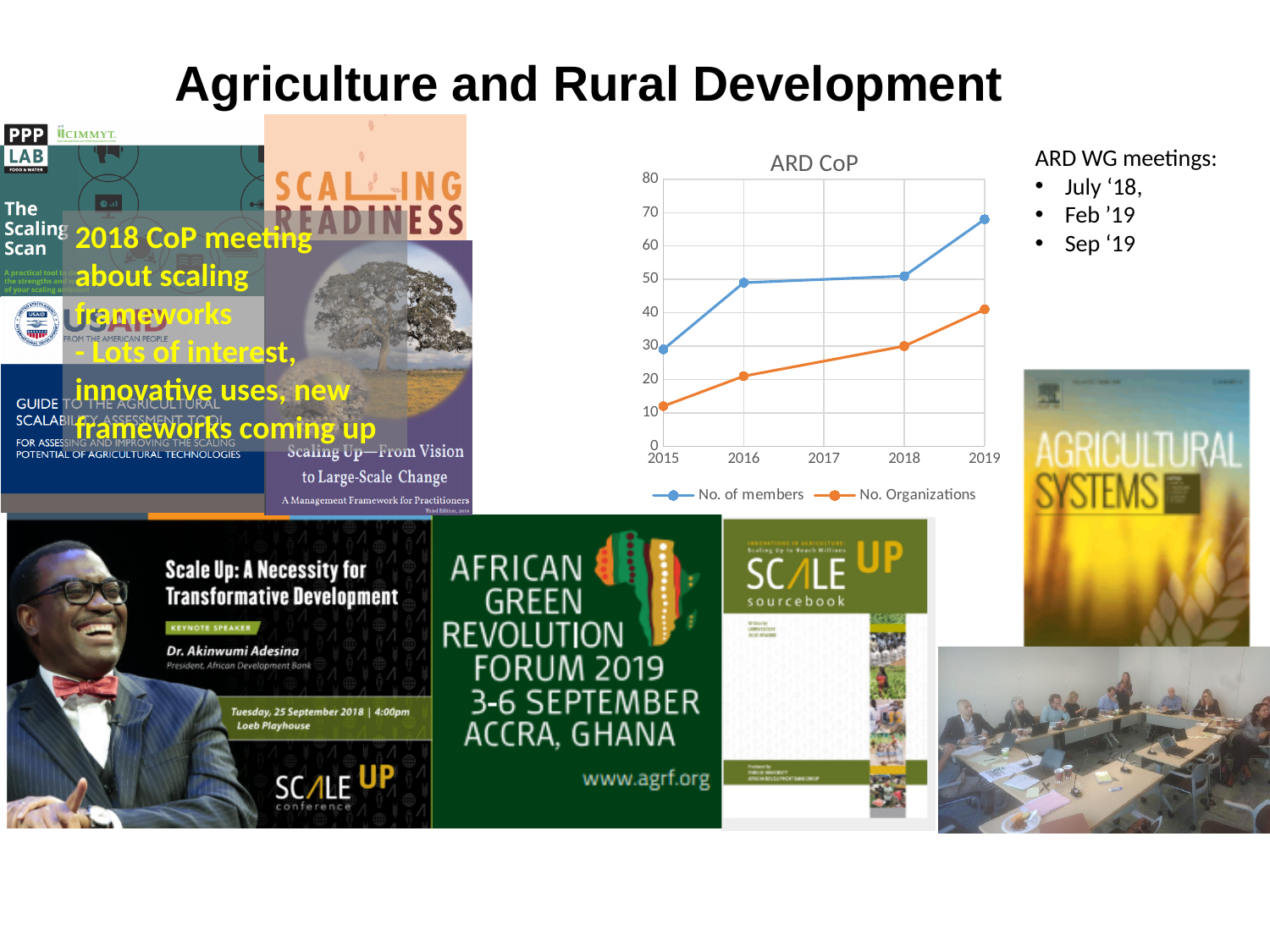
In the ARD CoP chart, which series has the larger value in 2019, No. of members or No. Organizations? No. of members In the ARD CoP chart, is the value for No. of members in 2016 greater or less than 60? less Which series is drawn in orange in the ARD CoP chart? No. Organizations In the ARD CoP chart, which year has the lowest value for No. Organizations? 2015 In the ARD CoP chart, is the value for No. of members in 2019 greater or less than 60? greater What kind of chart is the ARD CoP chart? line chart How many series does the legend of the ARD CoP chart list? 2 In the ARD CoP chart, which year has the highest value for No. of members? 2019 In the ARD CoP chart, is the value for No. Organizations in 2019 greater or less than 30? greater How many year labels are shown on the x axis of the ARD CoP chart? 5 What is the title of the chart on the slide? ARD CoP